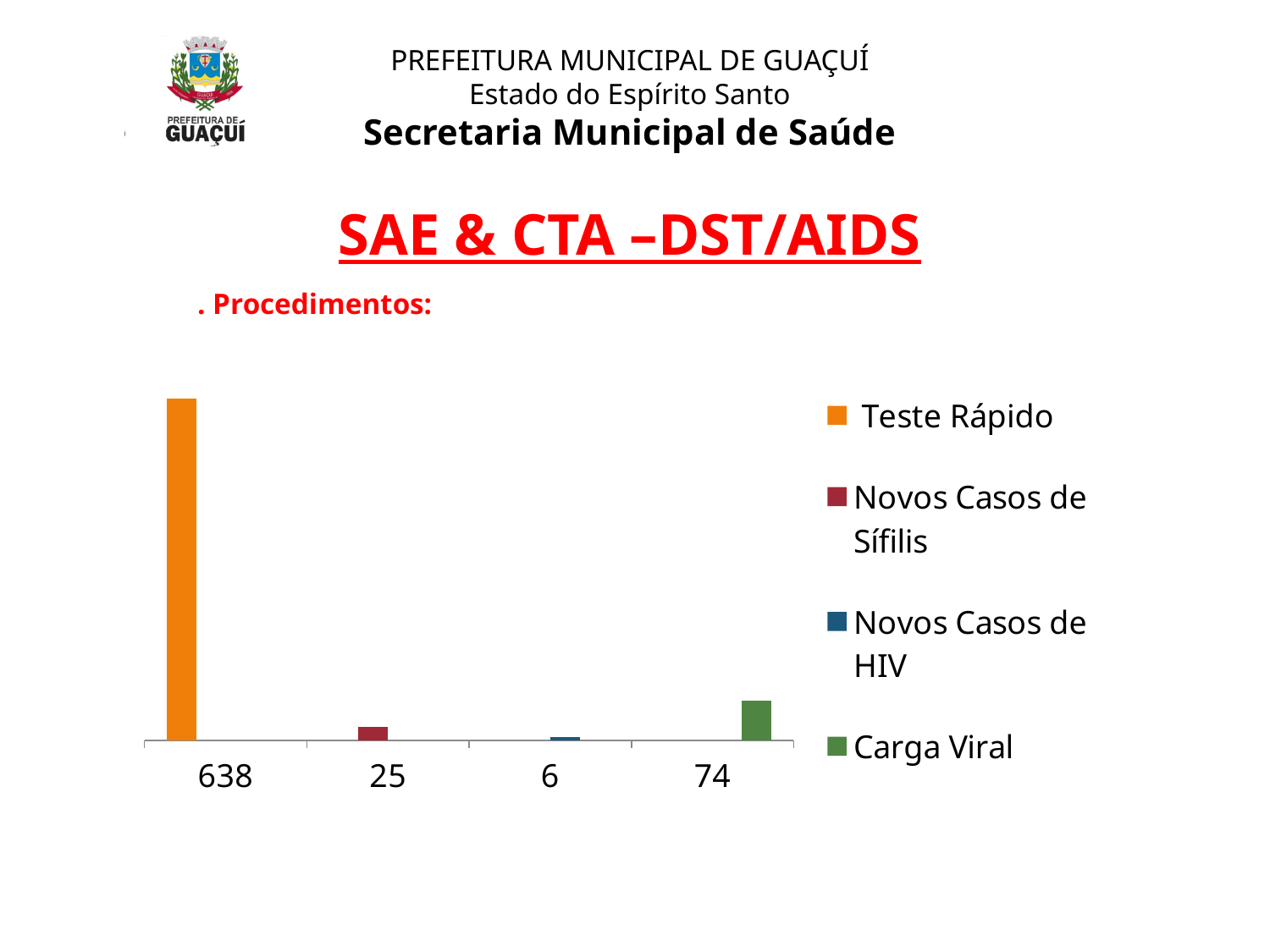
What value is shown for Carga Viral? 74 What value is shown for Novos Casos de Sífilis? 25 Which colour represents Carga Viral in the chart legend? green What kind of chart is shown on the slide? bar chart How many bars are plotted in the chart? 4 What value is shown for Novos Casos de HIV? 6 Which is larger, the value for Carga Viral or the value for Novos Casos de Sífilis? Carga Viral What is the difference between the value for Teste Rápido and the value for Carga Viral? 564 Which legend entry has the highest value in the chart? Teste Rápido What value is shown for Teste Rápido? 638 Which legend entry has the lowest value in the chart? Novos Casos de HIV How many entries does the chart legend list? 4